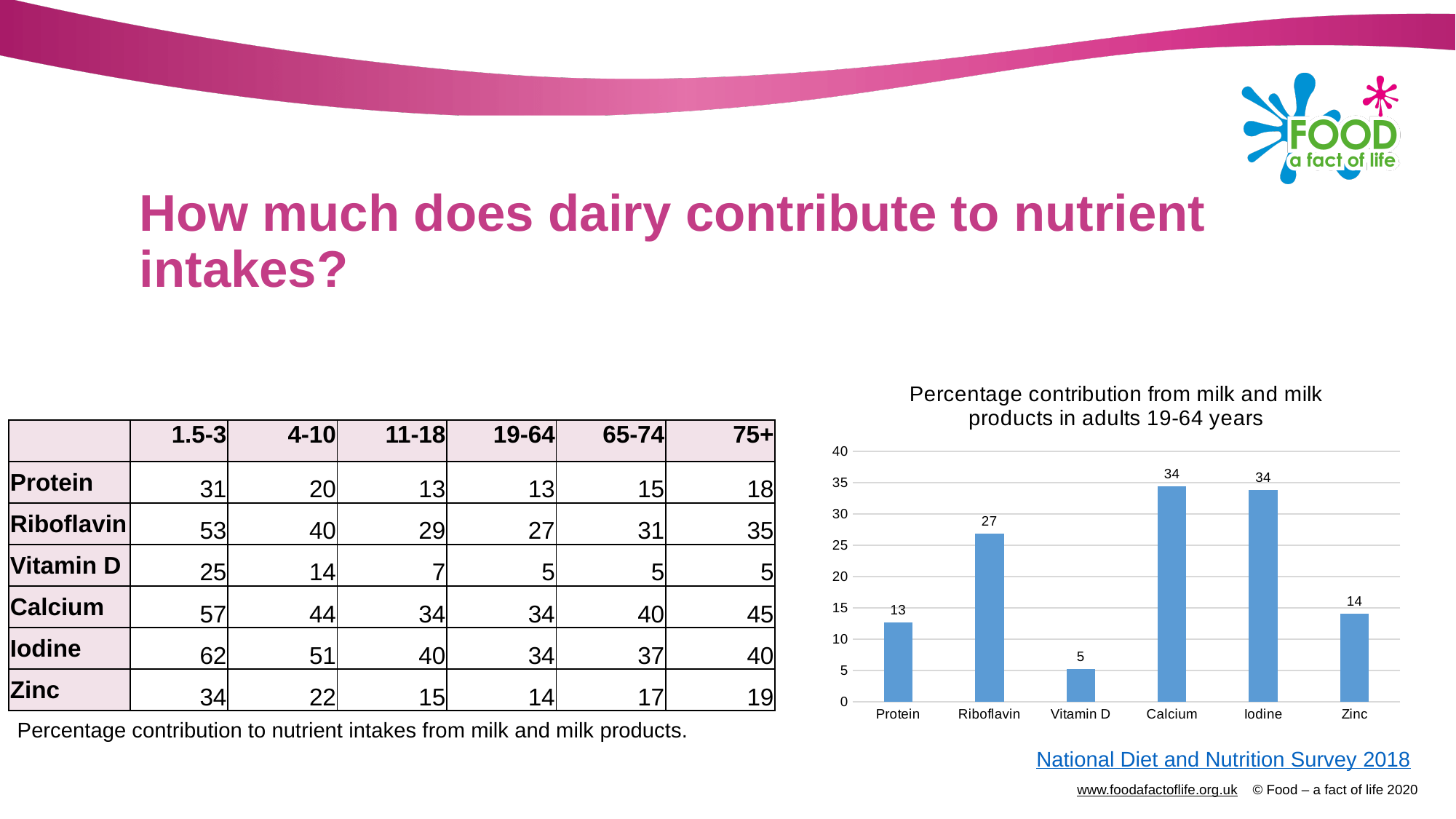
How many nutrients are shown on the x axis of the chart? 6 Is the value for Iodine in the chart greater or less than 30? greater Which has a larger value in the chart, Riboflavin or Zinc? Riboflavin What is the difference between the values for Calcium and Vitamin D in the chart? 29 What is the value for Protein in the chart? 13 What is the value for Calcium in the chart? 34 What is the title of the chart? Percentage contribution from milk and milk products in adults 19-64 years What is the difference between the values for Riboflavin and Protein in the chart? 14 What is the value for Riboflavin in the chart? 27 Which nutrient has the lowest value in the chart? Vitamin D What kind of chart is shown on the slide? Bar chart What is the value for Zinc in the chart? 14